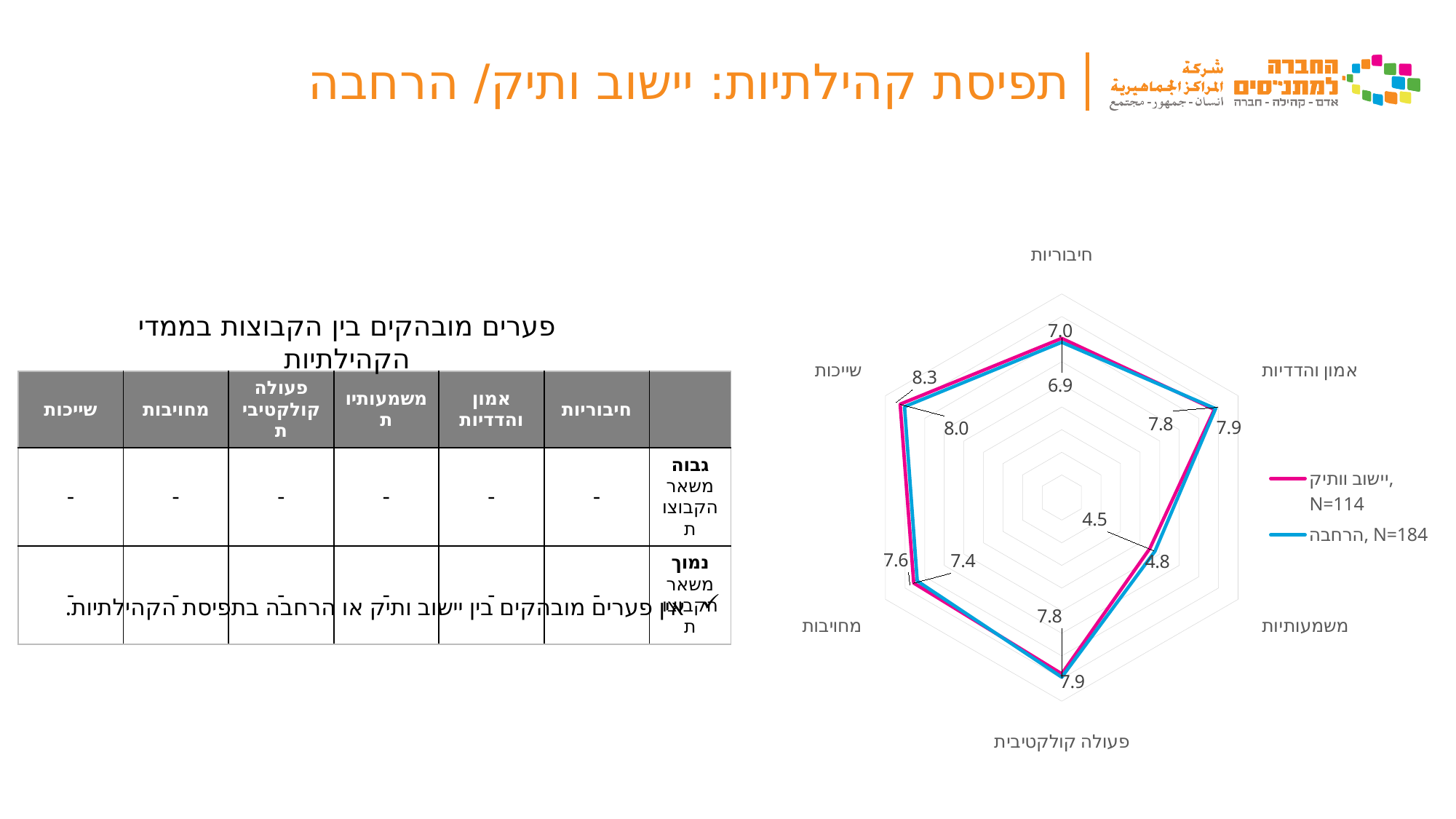
Which series has the larger value for משמעותיות? הרחבה, N=184 What is the value for שייכות for the יישוב ותיק, N=114 series? 8.3 What is the difference between the two series' values for שייכות? 0.3 Which category has the lowest values for both series in the radar chart? משמעותיות What is the value for שייכות for the הרחבה, N=184 series? 8.0 What is the value for משמעותיות for the הרחבה, N=184 series? 4.8 What kind of chart is shown on the slide? Radar chart How many categories (axes) does the radar chart have? 6 What colour is the line for the הרחבה, N=184 series? Blue Which category has the highest value for the יישוב ותיק, N=114 series? שייכות What is the value for משמעותיות for the יישוב ותיק, N=114 series? 4.5 How many series does the chart legend list? 2